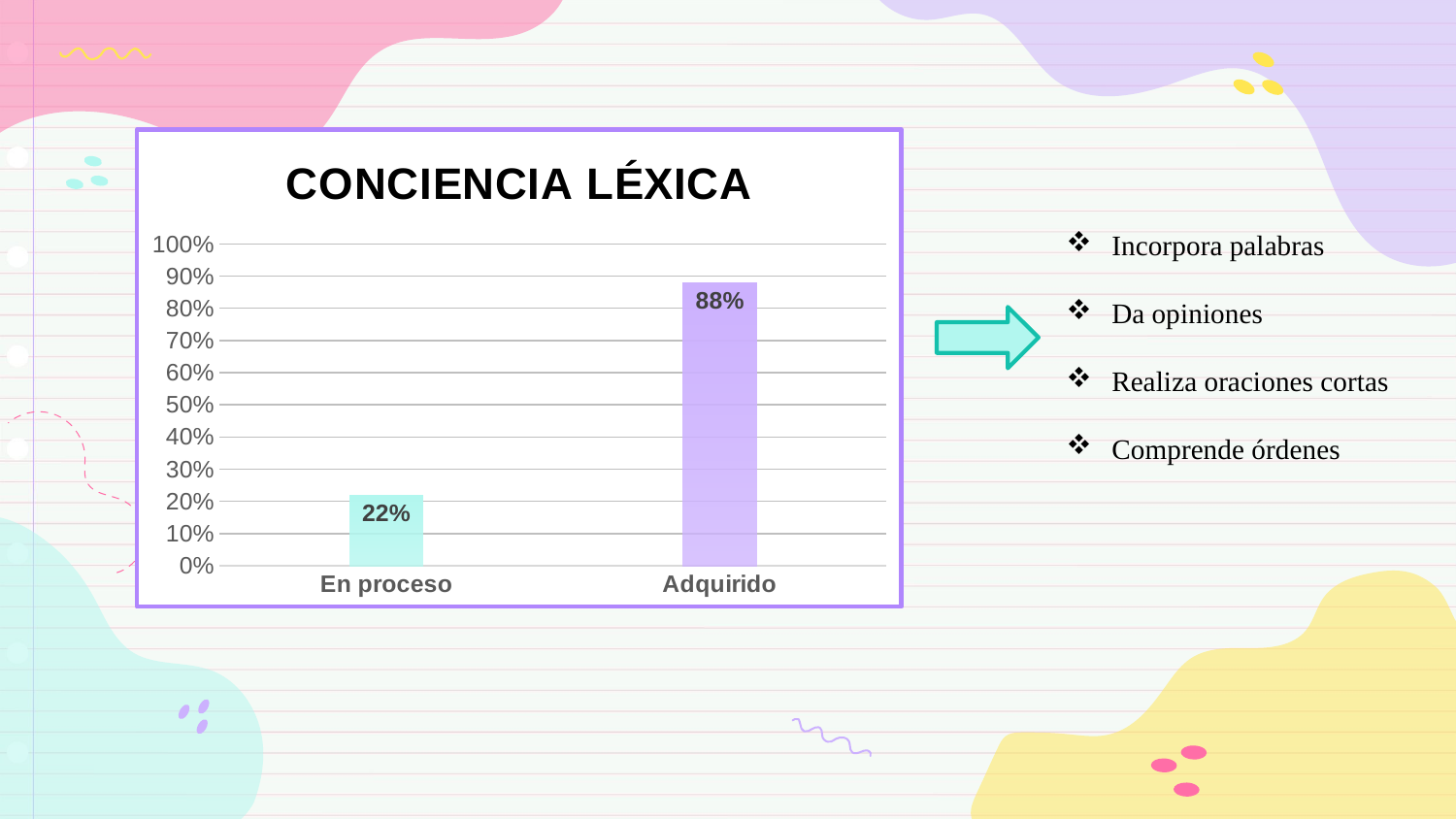
Is the value for 'Adquirido' greater or less than 80%? greater What is the value for 'Adquirido'? 88% How many categories are shown on the x axis? 2 Is the value for 'En proceso' greater or less than 30%? less Which category has the highest value? Adquirido What kind of chart is shown on the slide? bar chart What is the difference between the values for 'Adquirido' and 'En proceso'? 66% What is the value for 'En proceso'? 22% Which is larger, the value for 'En proceso' or the value for 'Adquirido'? Adquirido What is the title of the chart? CONCIENCIA LÉXICA Which category has the lowest value? En proceso What is the highest value shown on the y axis? 100%